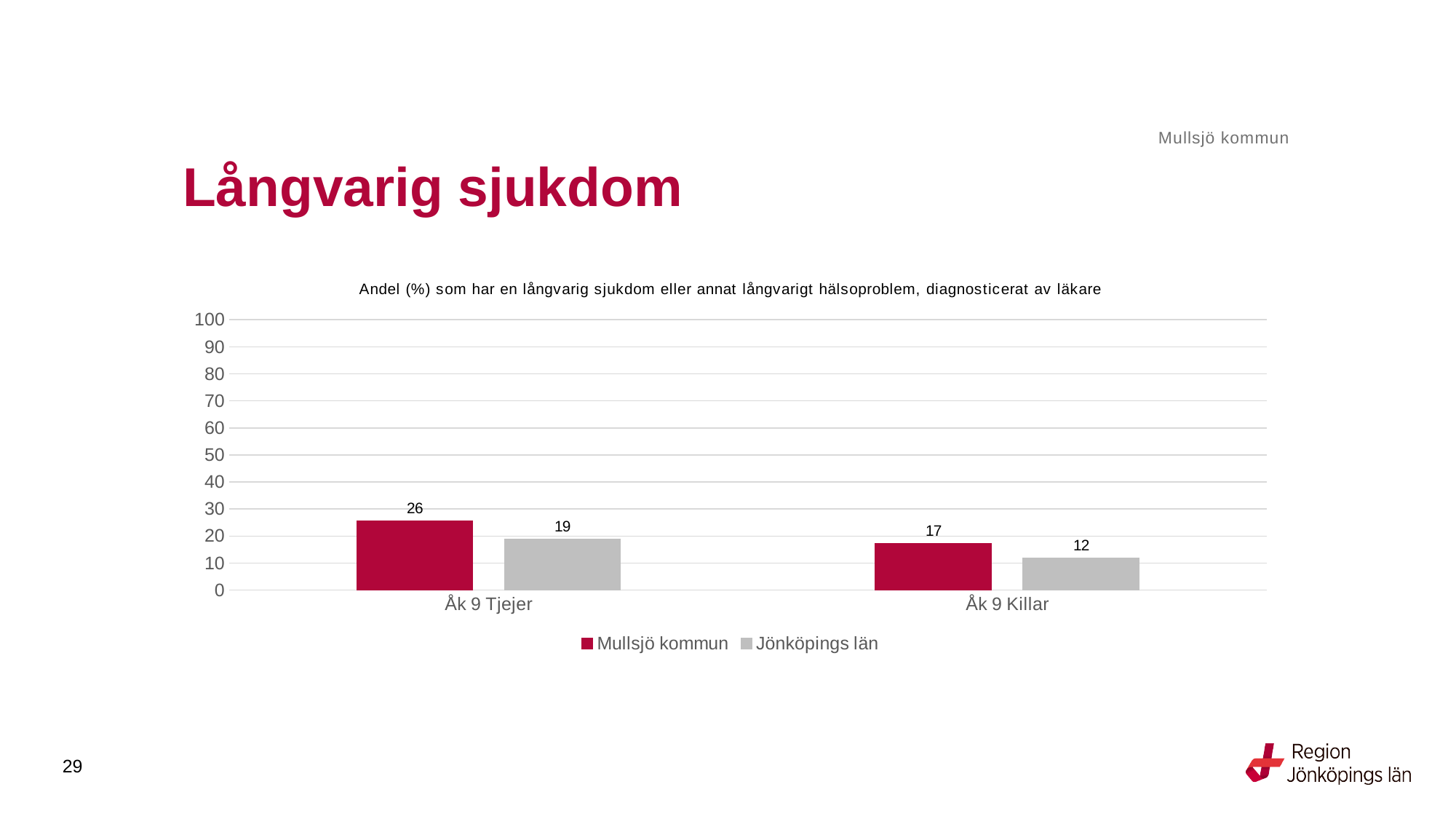
Which bar has the highest value in the chart? Mullsjö kommun, Åk 9 Tjejer What kind of chart is shown on the slide? bar chart Which bar has the lowest value in the chart? Jönköpings län, Åk 9 Killar How many categories are shown on the x axis? 2 How many series does the legend list? 2 Which is larger: Mullsjö kommun for Åk 9 Killar or Jönköpings län for Åk 9 Tjejer? Jönköpings län for Åk 9 Tjejer What is the value for Jönköpings län in the Åk 9 Tjejer category? 19 What is the value for Jönköpings län in the Åk 9 Killar category? 12 What is the value for Mullsjö kommun in the Åk 9 Tjejer category? 26 Is the value for Mullsjö kommun in Åk 9 Tjejer greater or less than 30? less What is the difference between Mullsjö kommun and Jönköpings län for Åk 9 Tjejer? 7 What is the difference between Mullsjö kommun and Jönköpings län for Åk 9 Killar? 5